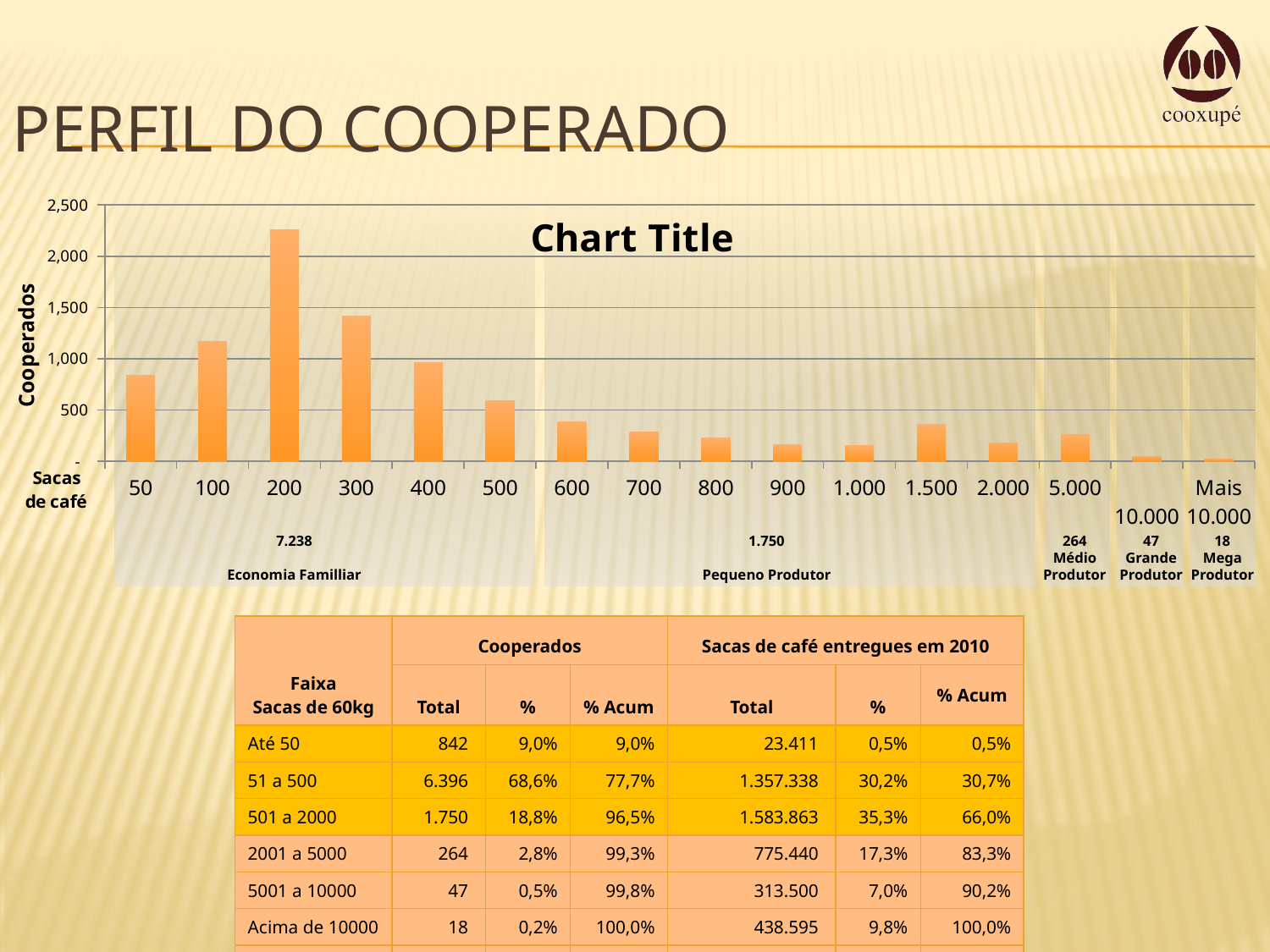
Which has more Cooperados, the 1.500 category or the 2.000 category? 1.500 Is the value for the 100 category greater or less than 1,000? greater Is the value for the 200 category greater or less than 2,000? greater Do the bar values rise or fall from the 200 category to the 1.000 category? fall What is the label on the vertical axis of the chart? Cooperados Is the value for the 600 category greater or less than 500? less What kind of chart is shown on the slide? bar chart How many categories are shown along the x axis of the chart? 16 Which has more Cooperados, the 100 category or the 300 category? 300 Which category has the highest number of Cooperados in the chart? 200